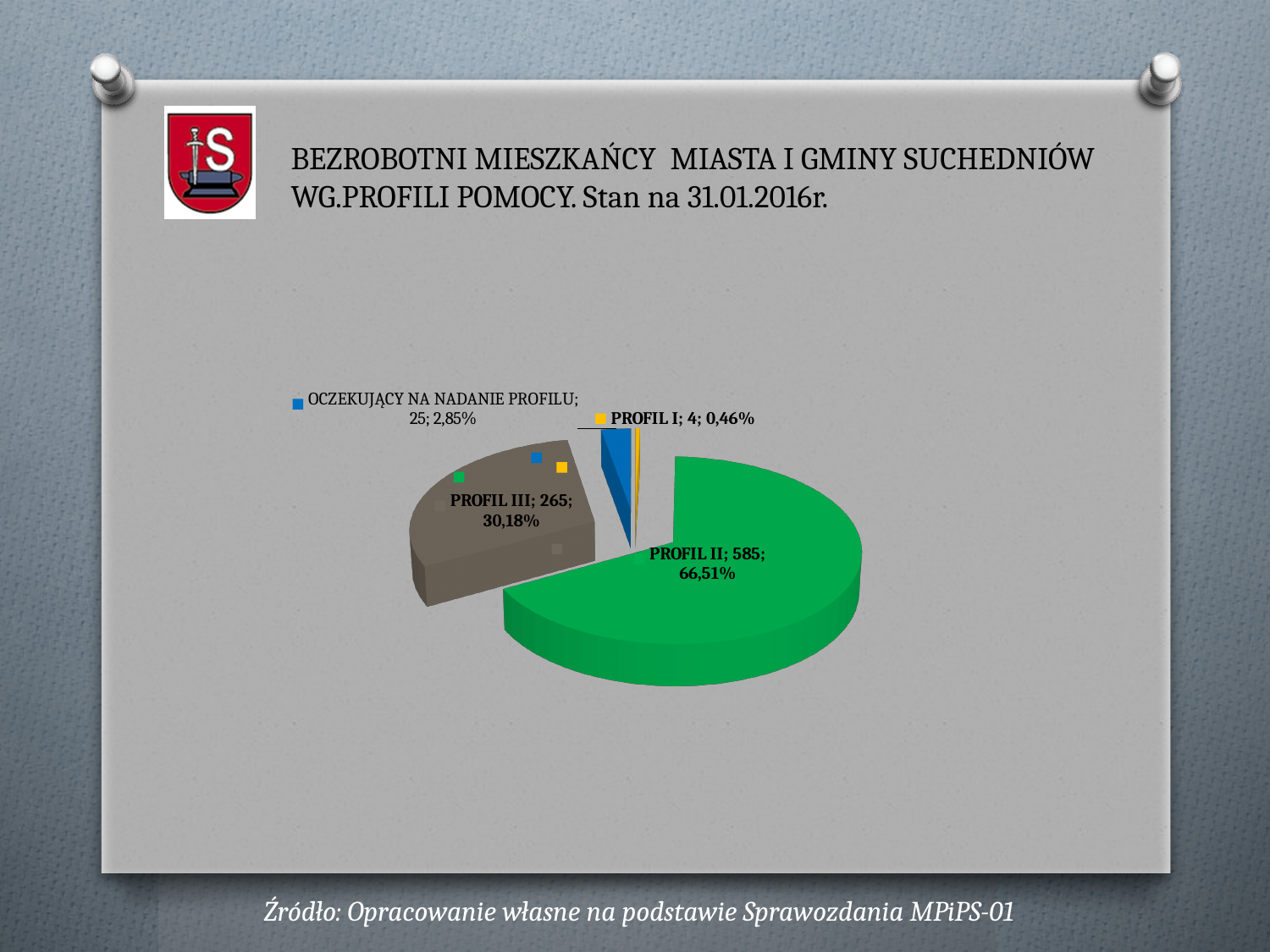
What kind of chart is shown on the slide? pie chart What is the value for OCZEKUJĄCY NA NADANIE PROFILU? 25 Which category has the smallest slice? PROFIL I What is the value for PROFIL I? 4 Which category has the largest slice? PROFIL II What share of the pie does PROFIL III represent? 30,18% What is the value for PROFIL II? 585 Which is larger, the value for PROFIL III or the value for OCZEKUJĄCY NA NADANIE PROFILU? PROFIL III What share of the pie does PROFIL II represent? 66,51% How many slices does the pie chart have? 4 What is the value for PROFIL III? 265 What is the difference between the values for PROFIL II and PROFIL III? 320